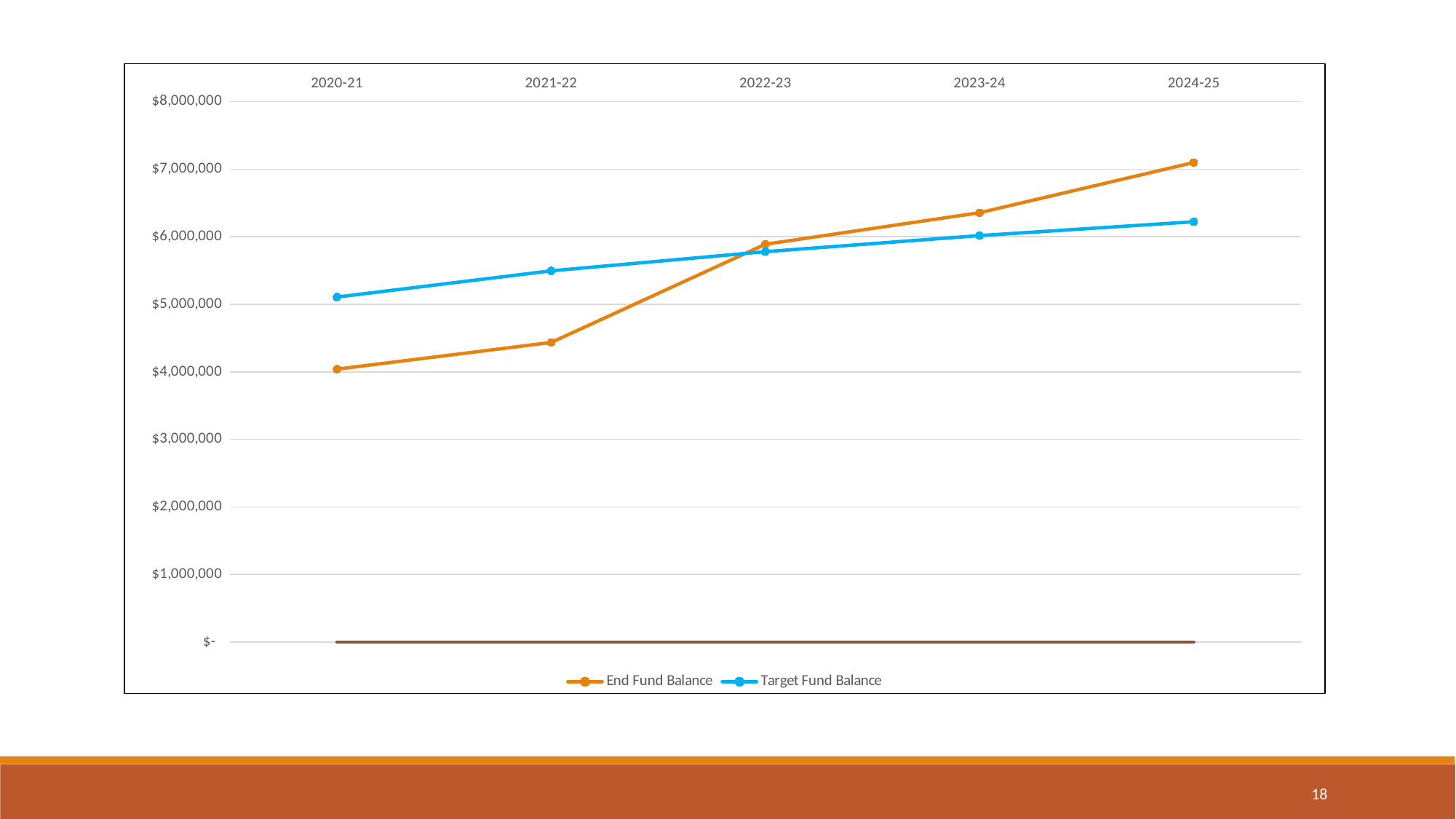
In 2024-25, which is larger: the End Fund Balance or the Target Fund Balance? End Fund Balance In which year is the Target Fund Balance lowest? 2020-21 Which series is shown in orange according to the legend? End Fund Balance In which year is the End Fund Balance highest? 2024-25 Is the Target Fund Balance for 2020-21 greater or less than $5,000,000? greater What kind of chart is shown on the slide? line chart Is the End Fund Balance for 2023-24 greater or less than $6,000,000? greater How many fiscal years are plotted along the x axis? 5 Is the End Fund Balance for 2020-21 greater or less than $5,000,000? less In 2020-21, which is larger: the End Fund Balance or the Target Fund Balance? Target Fund Balance Does the End Fund Balance rise or fall from 2020-21 to 2024-25? rise How many series does the legend list? 2